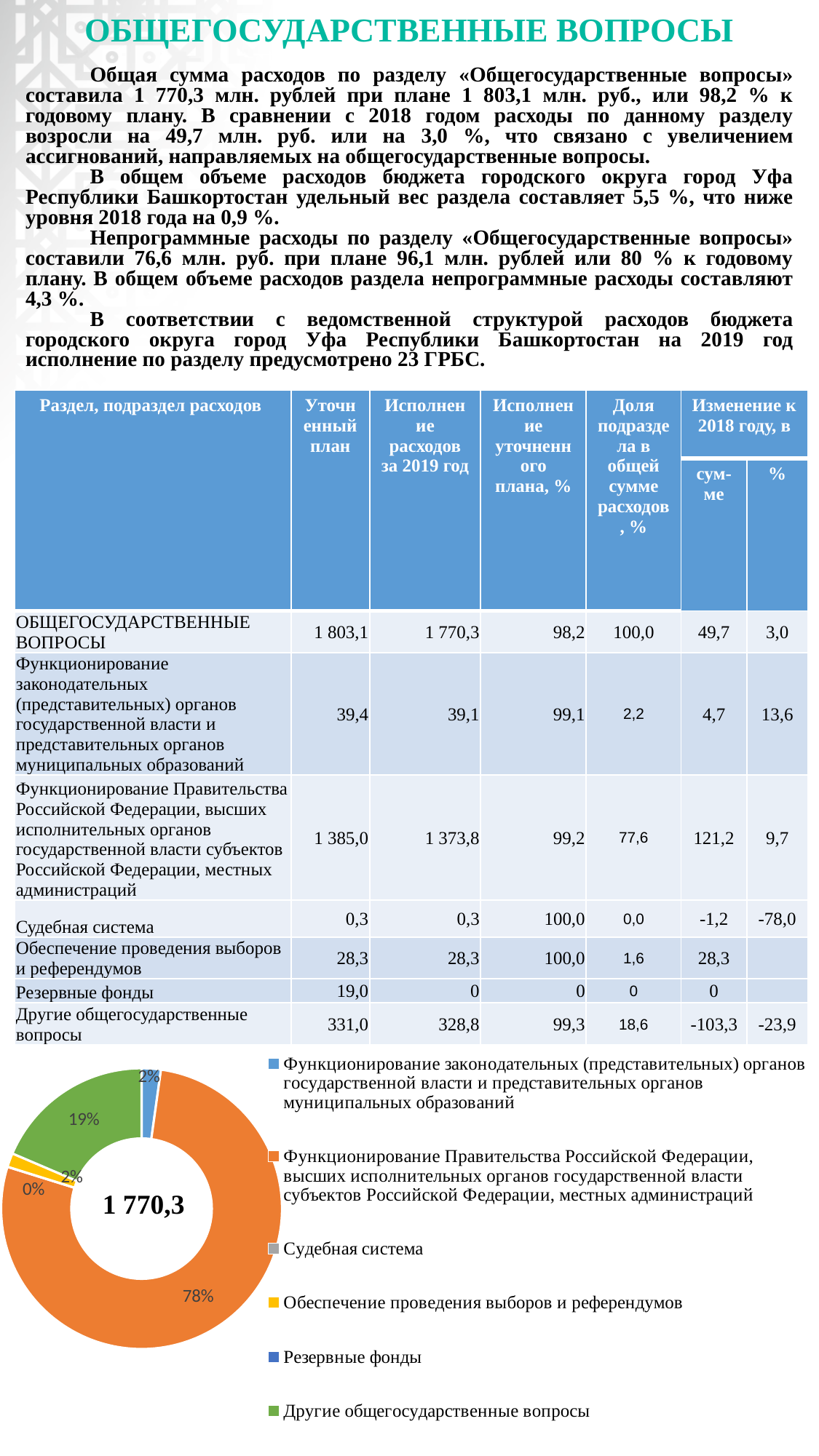
In the doughnut chart, what share is shown for «Функционирование Правительства Российской Федерации, высших исполнительных органов государственной власти субъектов Российской Федерации, местных администраций»? 78% In the doughnut chart, what share is shown for «Судебная система»? 0% What is the difference in percentage points between the 78% slice and the 19% slice in the doughnut chart? 59 In the doughnut chart, what share is shown for «Другие общегосударственные вопросы»? 19% What colour is the largest slice of the doughnut chart? orange In the doughnut chart, which slice is larger: «Другие общегосударственные вопросы» or «Обеспечение проведения выборов и референдумов»? Другие общегосударственные вопросы In the doughnut chart, what share is shown for «Функционирование законодательных (представительных) органов государственной власти и представительных органов муниципальных образований»? 2% What kind of chart is shown at the bottom of the slide? doughnut chart In the doughnut chart, what share is shown for «Обеспечение проведения выборов и референдумов»? 2% How many entries does the legend of the doughnut chart list? 6 Which category has the largest slice in the doughnut chart? Функционирование Правительства Российской Федерации, высших исполнительных органов государственной власти субъектов Российской Федерации, местных администраций What value is printed in the centre of the doughnut chart? 1 770,3